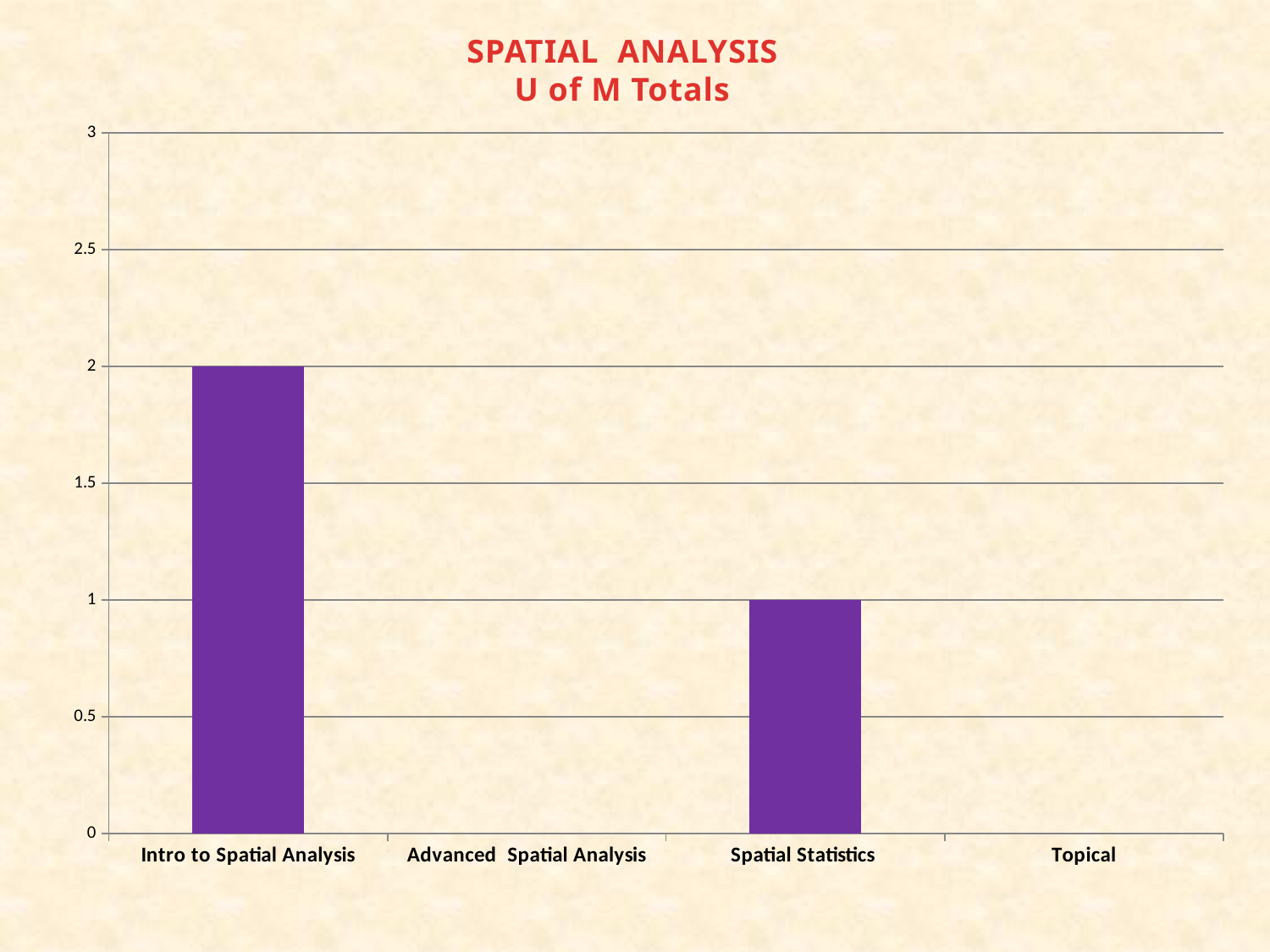
Is the value for Spatial Statistics greater or less than 1.5? less What is the value for Spatial Statistics? 1 Is the value for Intro to Spatial Analysis greater or less than 1.5? greater What type of chart is shown on the slide? bar chart What is the title of the chart? SPATIAL ANALYSIS U of M Totals What is the difference between the values for Intro to Spatial Analysis and Spatial Statistics? 1 What colour are the bars in the chart? purple Which category has the highest value? Intro to Spatial Analysis How many categories are shown on the x axis? 4 Which is larger, the value for Intro to Spatial Analysis or the value for Spatial Statistics? Intro to Spatial Analysis What is the value for Intro to Spatial Analysis? 2 What is the highest value shown on the y axis? 3